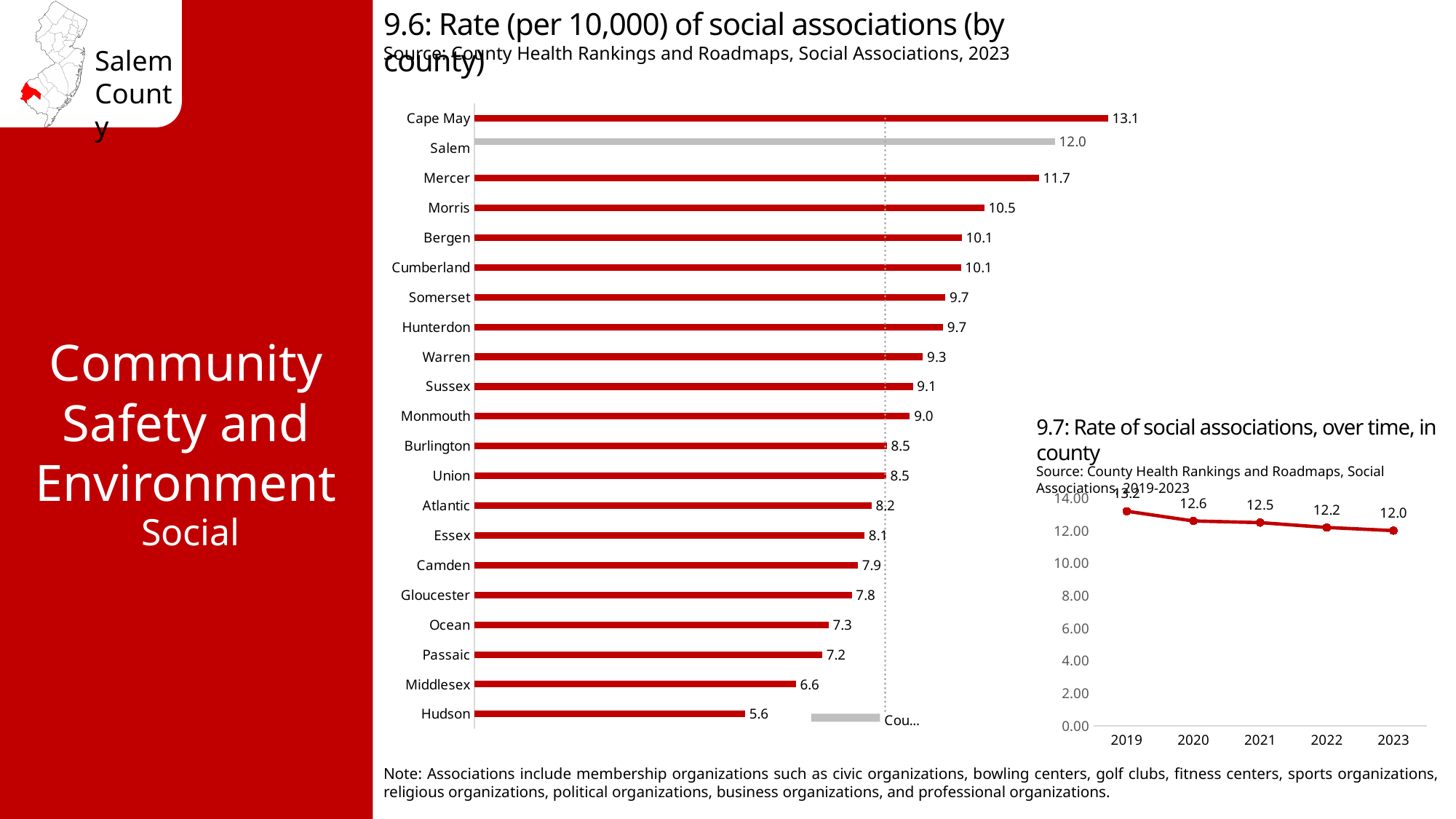
In chart 9.7, does the rate of social associations rise or fall from 2019 to 2023? Fall What kind of chart is chart 9.6? Bar chart In chart 9.6, which county has the lowest rate of social associations? Hudson In chart 9.7, what was the rate of social associations in 2023? 12.0 In chart 9.6, what is the rate of social associations for Salem? 12.0 In chart 9.6, which county has the highest rate of social associations? Cape May In chart 9.6, which county has a higher rate, Mercer or Morris? Mercer In chart 9.7, what was the rate of social associations in 2019? 13.2 In chart 9.6, what is the rate of social associations for Hunterdon? 9.7 In chart 9.6, what is the difference between the rates for Cape May and Hudson? 7.5 In chart 9.6, how many counties are shown? 21 In chart 9.7, what is the difference between the 2019 and 2023 rates? 1.2